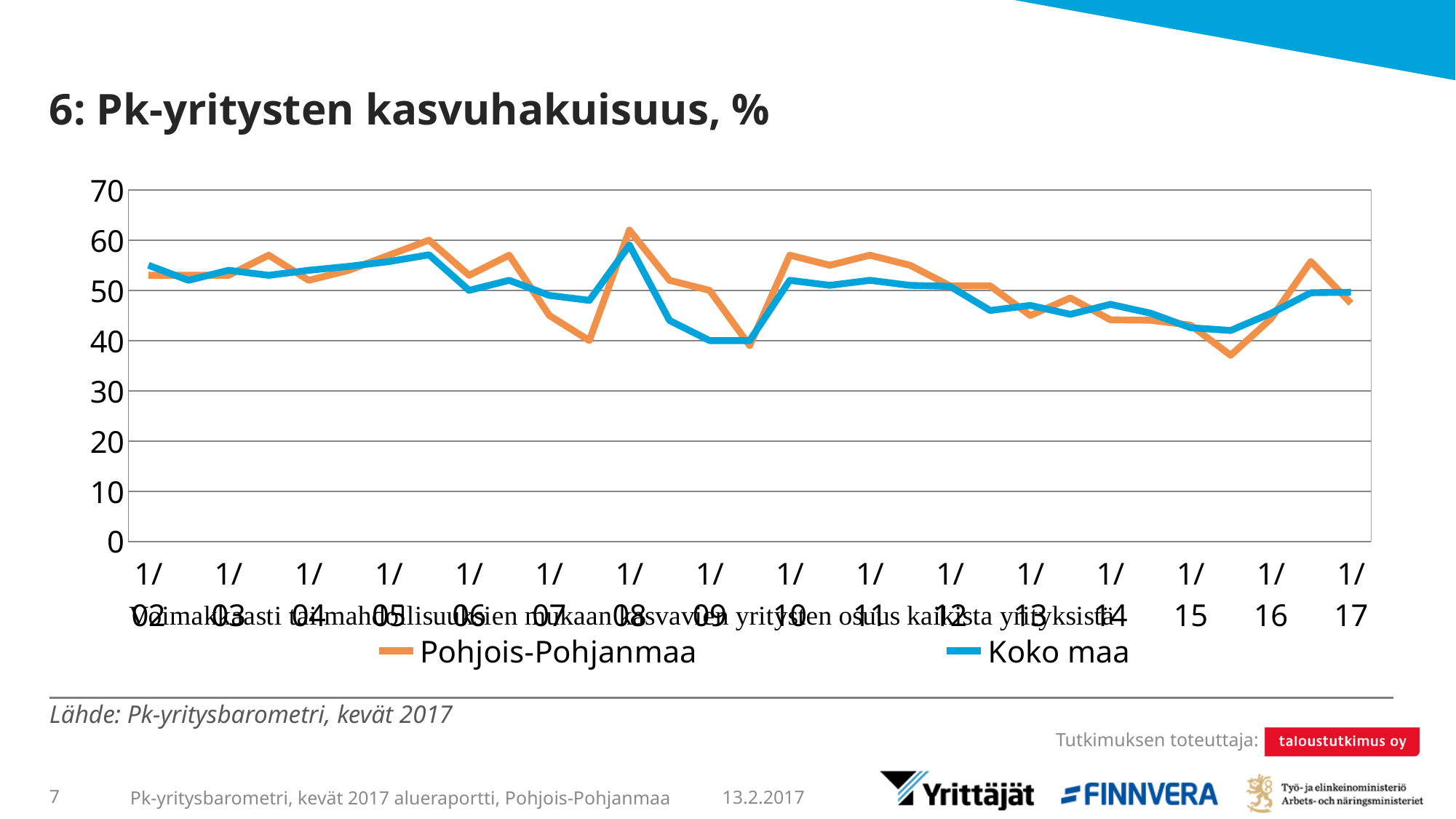
Is the value for Pohjois-Pohjanmaa at 1/08 greater or less than 60? greater Is the value for Koko maa at 1/14 greater or less than 50? less Is the value for Koko maa at 1/02 greater or less than 50? greater At which x-axis point does the Pohjois-Pohjanmaa series reach its highest value? 1/08 Does the Pohjois-Pohjanmaa series rise or fall between 1/10 and 1/15? fall Which series is drawn in blue? Koko maa At 1/09, which series has the higher value, Pohjois-Pohjanmaa or Koko maa? Pohjois-Pohjanmaa How many series does the legend list? 2 What is the title of the chart? 6: Pk-yritysten kasvuhakuisuus, % What kind of chart is shown on the slide? line chart How many year labels (1/02 to 1/17) are shown on the x axis? 16